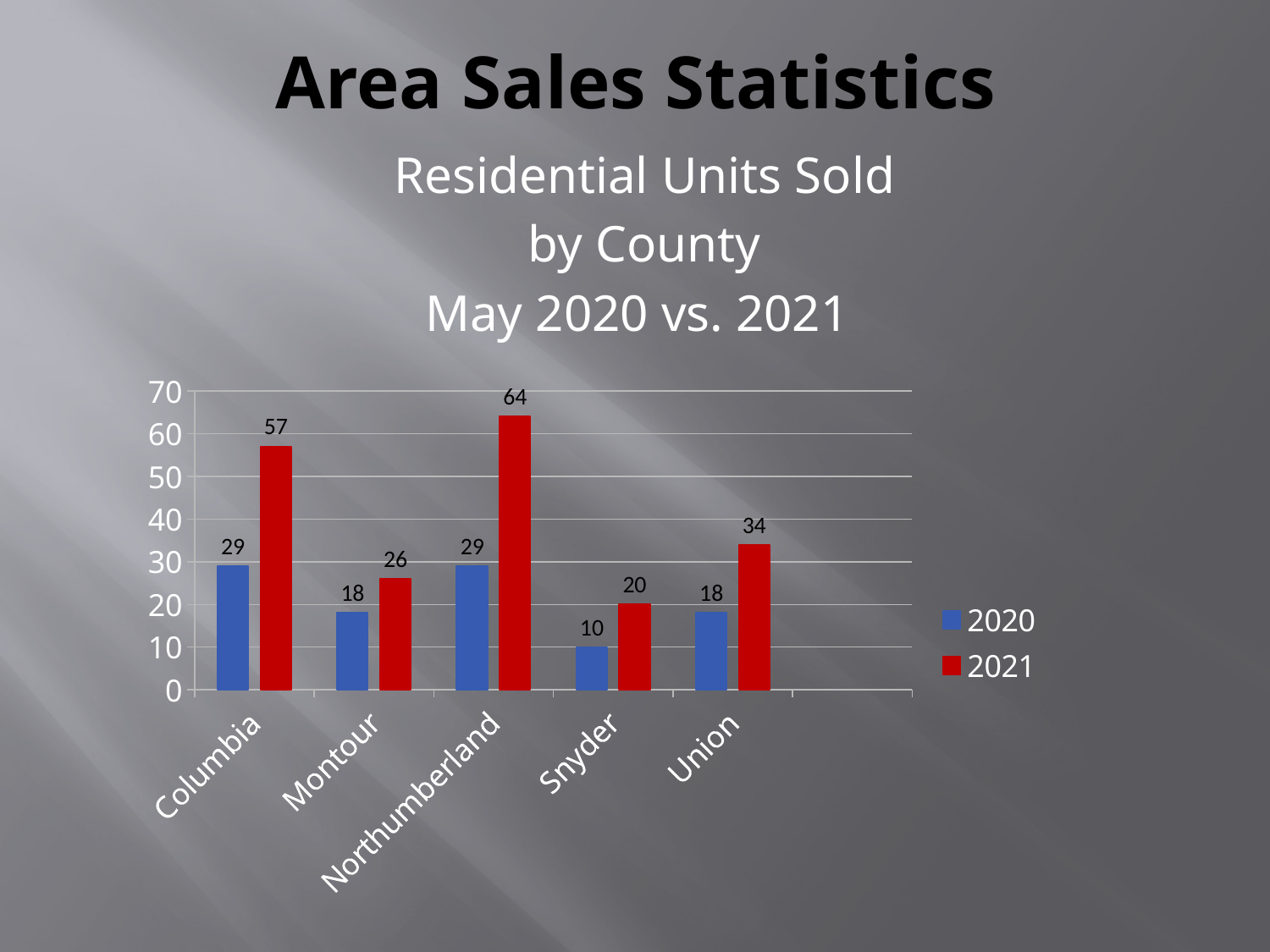
How many series does the legend list? 2 Which colour represents the 2021 series in the legend? Red Which is larger, the 2020 value for Montour or the 2020 value for Columbia? Columbia What is the difference between the 2021 and 2020 values for Northumberland? 35 What is the value for Union in 2021? 34 What is the value for Snyder in 2020? 10 How many counties are shown on the x axis? 5 How many residential units were sold in Columbia in 2021? 57 Which county has the lowest value in 2020? Snyder Which county has the highest value in 2021? Northumberland What is the difference between the 2021 values for Columbia and Montour? 31 What kind of chart is shown on the slide? Bar chart